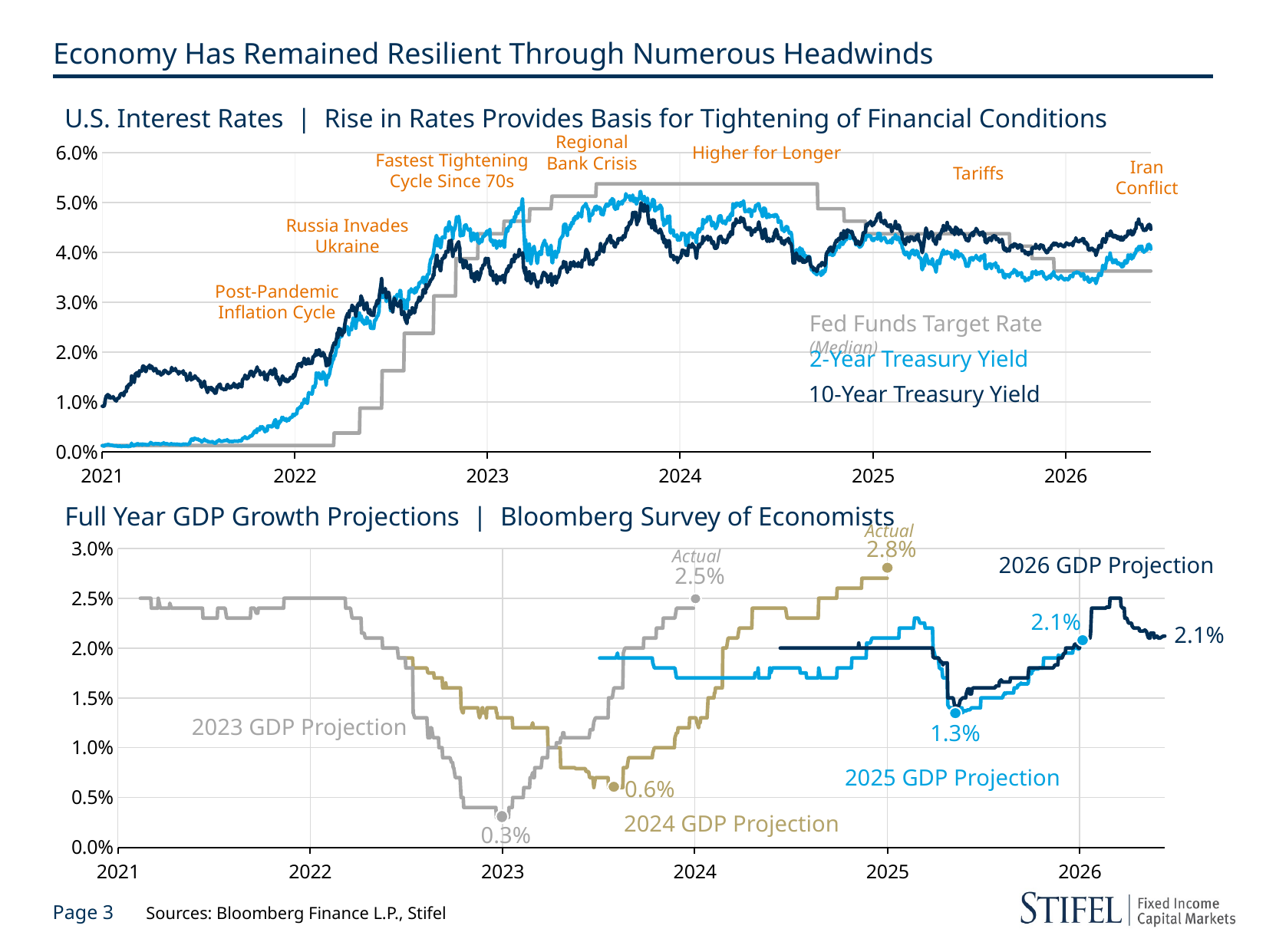
In the bottom chart, what is the lowest labeled value of the 2024 GDP Projection? 0.6% In the bottom chart, what is the labeled actual GDP growth for 2023? 2.5% In the bottom chart, what is the labeled actual GDP growth for 2024? 2.8% In the bottom chart, what is the latest labeled value of the 2026 GDP Projection? 2.1% What kind of chart is the top chart, 'U.S. Interest Rates'? Line chart In the bottom chart, what is the lowest labeled value of the 2023 GDP Projection? 0.3% In the top chart, which event annotation appears at the far right, near 2026? Iran Conflict How many series are shown in the top chart, 'U.S. Interest Rates'? 3 In the bottom chart, what is the lowest labeled value of the 2025 GDP Projection? 1.3% In the top chart, is the peak of the Fed Funds Target Rate greater or less than 5.0%? greater How many GDP projection series are shown in the bottom chart, 'Full Year GDP Growth Projections'? 4 In the bottom chart, what is the difference between the labeled actual GDP growth for 2024 and for 2023? 0.3%